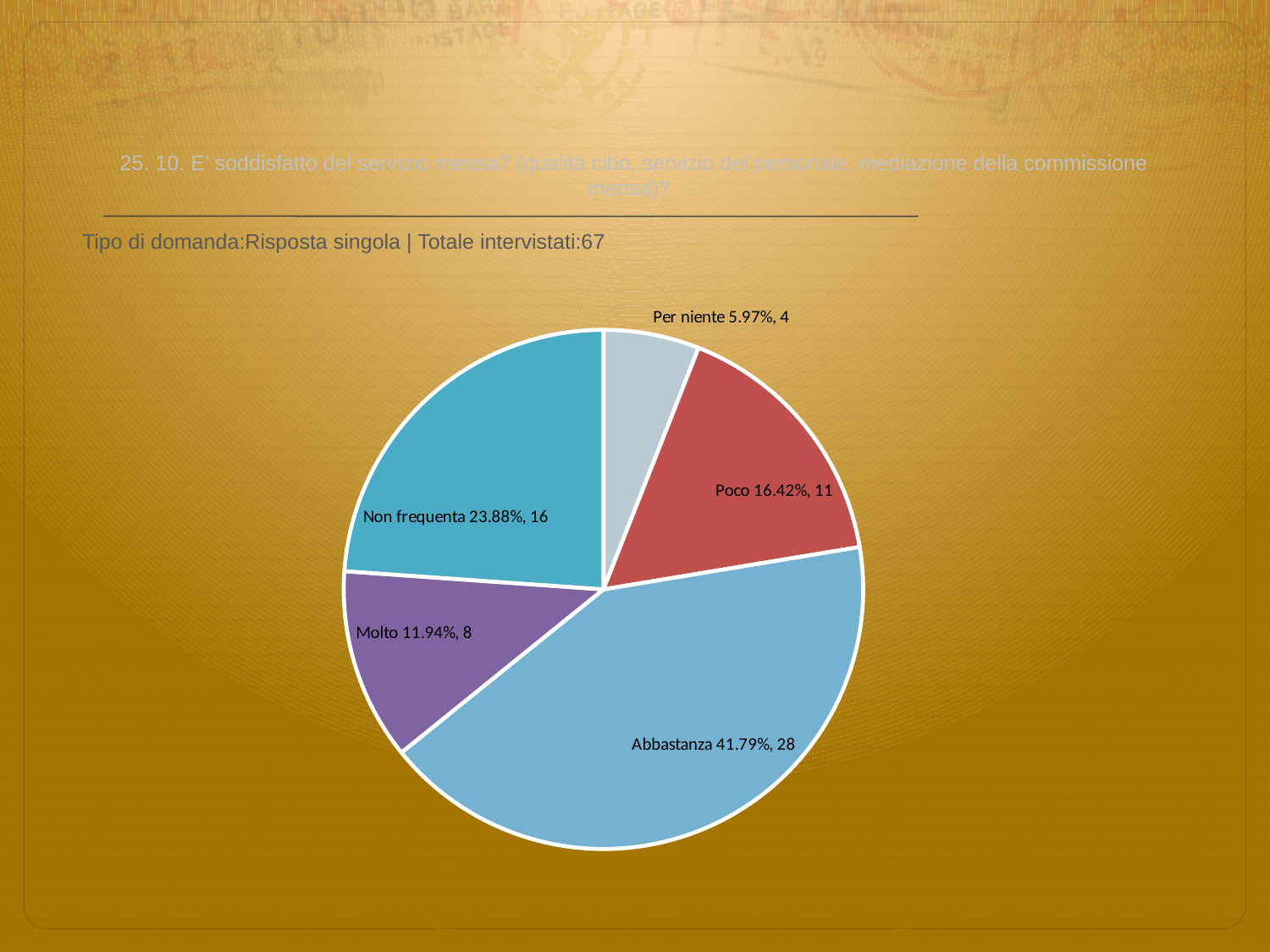
What percentage share does the 'Molto' slice have? 11.94% What percentage share does the 'Abbastanza' slice have? 41.79% What is the difference in respondent count between 'Abbastanza' and 'Non frequenta'? 12 Which category has the smallest slice? Per niente Which has more respondents, 'Poco' or 'Molto'? Poco Which category has the largest slice? Abbastanza What is the total number of respondents shown across all slices? 67 How many respondents answered 'Non frequenta'? 16 How many slices does the pie chart have? 5 What kind of chart is shown on the slide? pie chart How many respondents answered 'Poco'? 11 What colour is the 'Molto' slice? purple